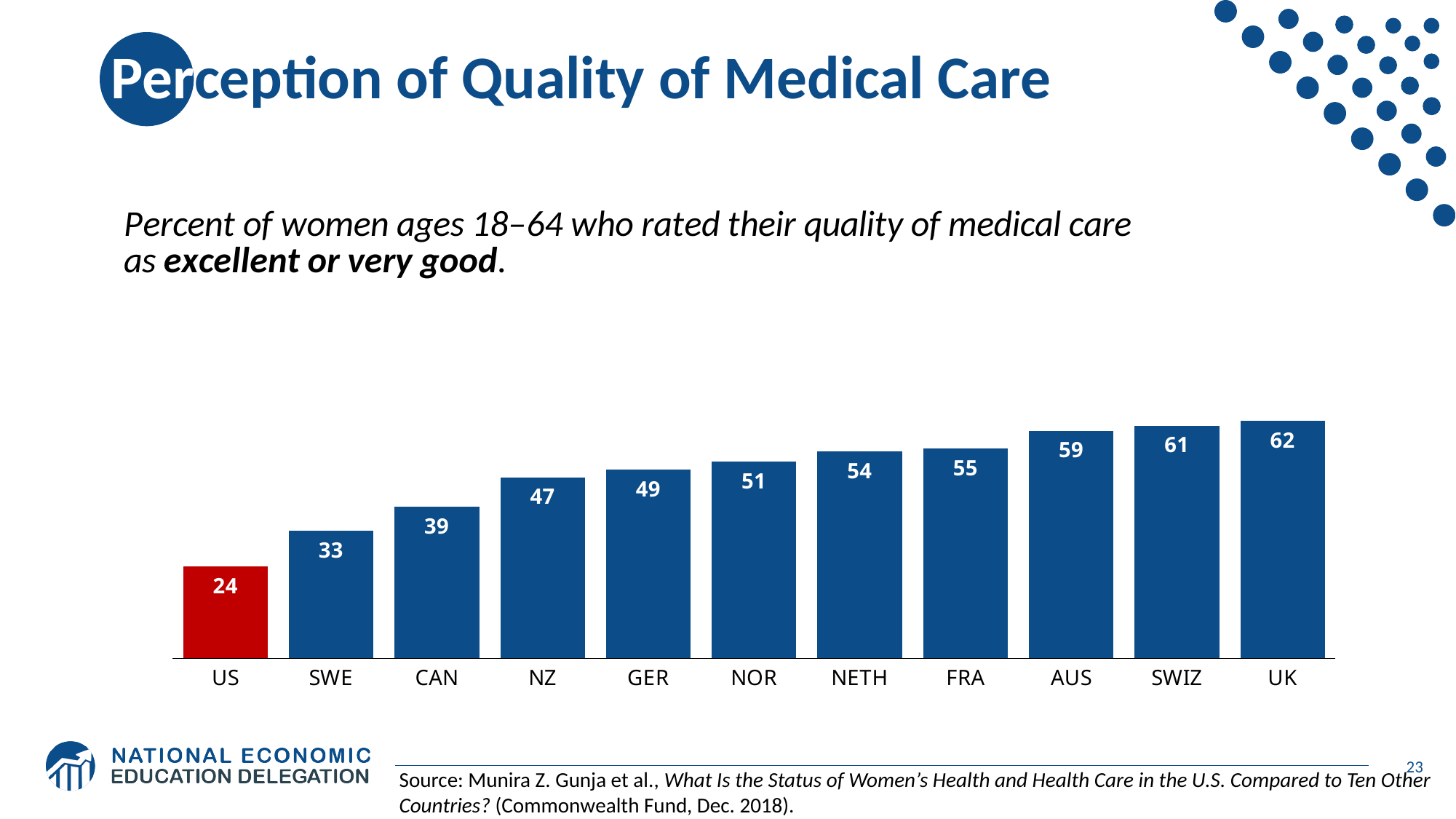
What is the value for AUS? 59 What is the value for the US? 24 How many countries are shown in the chart? 11 What is the difference between the values for UK and US? 38 What is the difference between the values for CAN and SWE? 6 Which country has the lowest value? US What kind of chart is shown on the slide? bar chart What is the value for GER? 49 Do the values rise or fall from left to right across the chart? rise Which is larger, the value for NOR or the value for NZ? NOR Which bar is coloured red rather than blue? US Which country has the highest value? UK